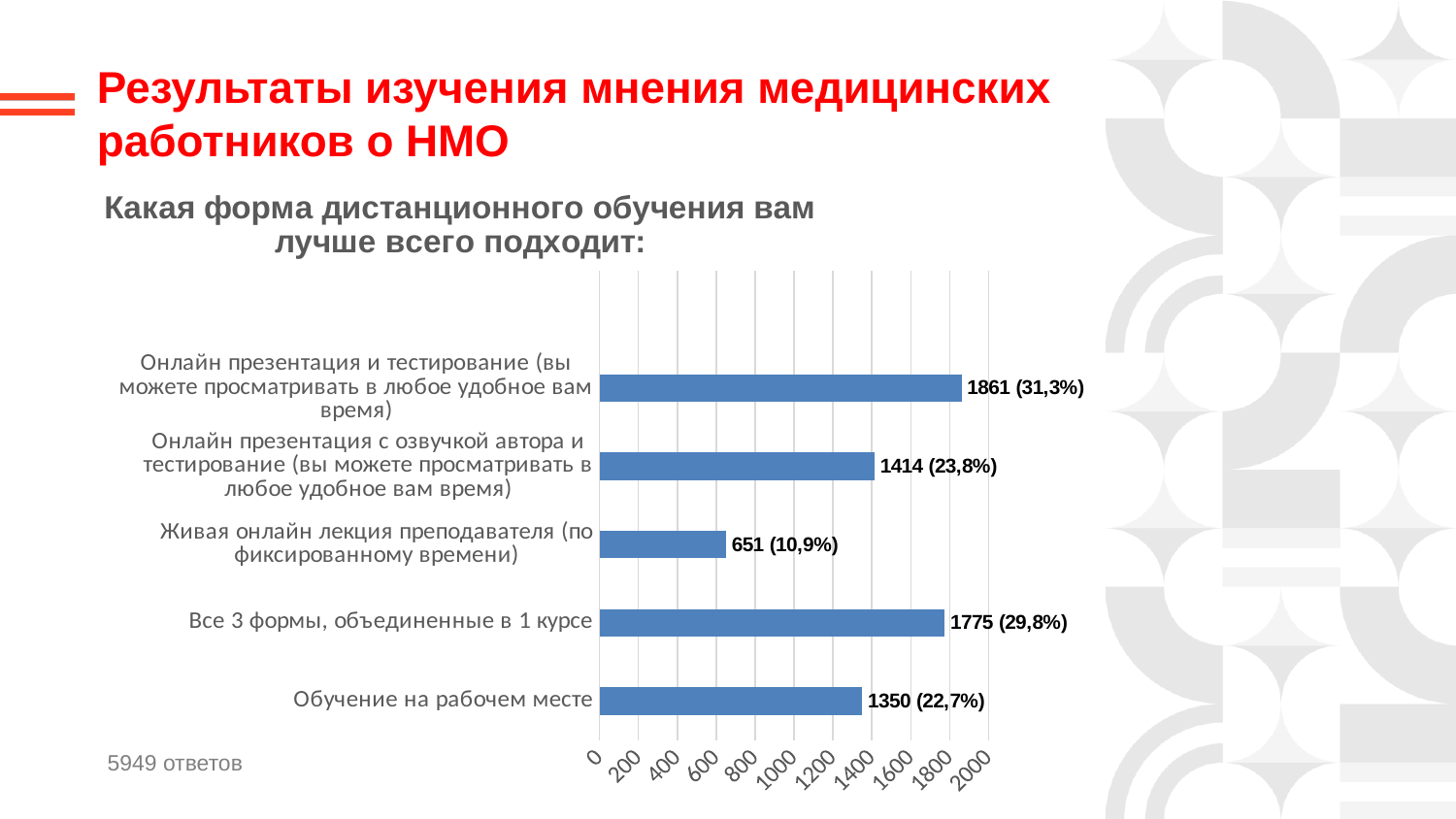
Which category has the highest value? Онлайн презентация и тестирование (вы можете просматривать в любое удобное вам время) What is the difference in count between "Онлайн презентация и тестирование" (1861) and "Все 3 формы, объединенные в 1 курсе" (1775)? 86 Which is larger: the value for "Онлайн презентация с озвучкой автора и тестирование" or for "Обучение на рабочем месте"? Онлайн презентация с озвучкой автора и тестирование Is the value for "Живая онлайн лекция преподавателя" greater or less than 800? less What value is shown for "Обучение на рабочем месте"? 1350 (22,7%) Which category has the lowest value? Живая онлайн лекция преподавателя (по фиксированному времени) What type of chart is shown on the slide? bar chart What value is shown for "Все 3 формы, объединенные в 1 курсе"? 1775 (29,8%) What value is shown for "Живая онлайн лекция преподавателя (по фиксированному времени)"? 651 (10,9%) How many categories are shown in the chart? 5 What percentage is shown for "Онлайн презентация с озвучкой автора и тестирование"? 23,8% How many responses does the note below the chart report? 5949 ответов